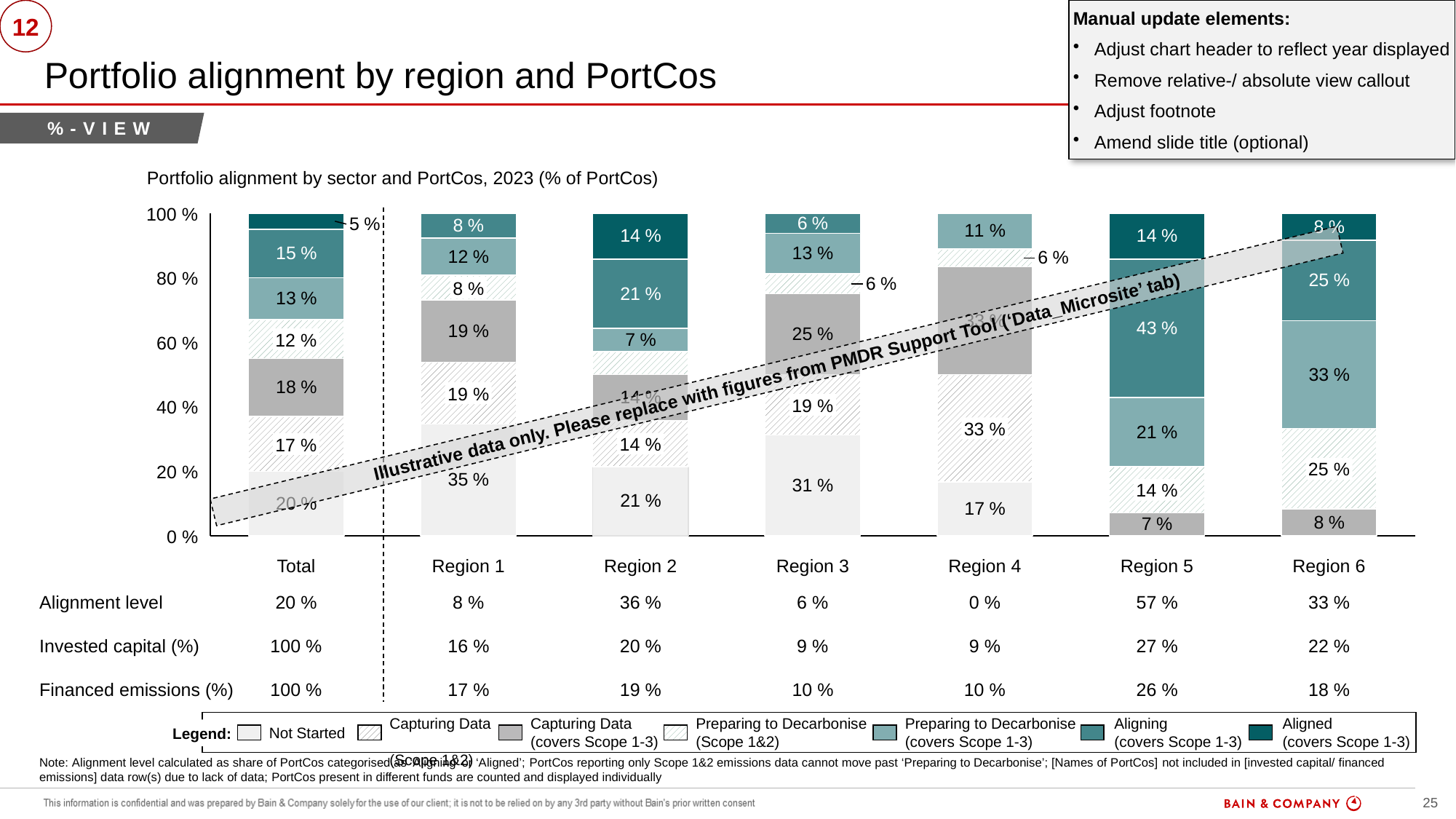
What is the 'Not Started' value for Region 1? 35 % How many categories are plotted along the x axis of the chart? 7 Which has the larger 'Aligning (covers Scope 1-3)' segment, Region 5 or Region 6? Region 5 What is the difference between the 'Aligning (covers Scope 1-3)' and 'Aligned (covers Scope 1-3)' segments for Region 2? 7 % What is the 'Preparing to Decarbonise (covers Scope 1-3)' value for Region 4? 11 % Which region has the largest 'Not Started' segment? Region 1 What is the 'Aligning (covers Scope 1-3)' value for Region 5? 43 % What is the 'Not Started' value for Region 3? 31 % What is the title of the chart? Portfolio alignment by sector and PortCos, 2023 (% of PortCos) What is the 'Aligning (covers Scope 1-3)' value for Region 6? 25 % What kind of chart is shown on the slide? Stacked bar chart How many series does the chart legend list? 7